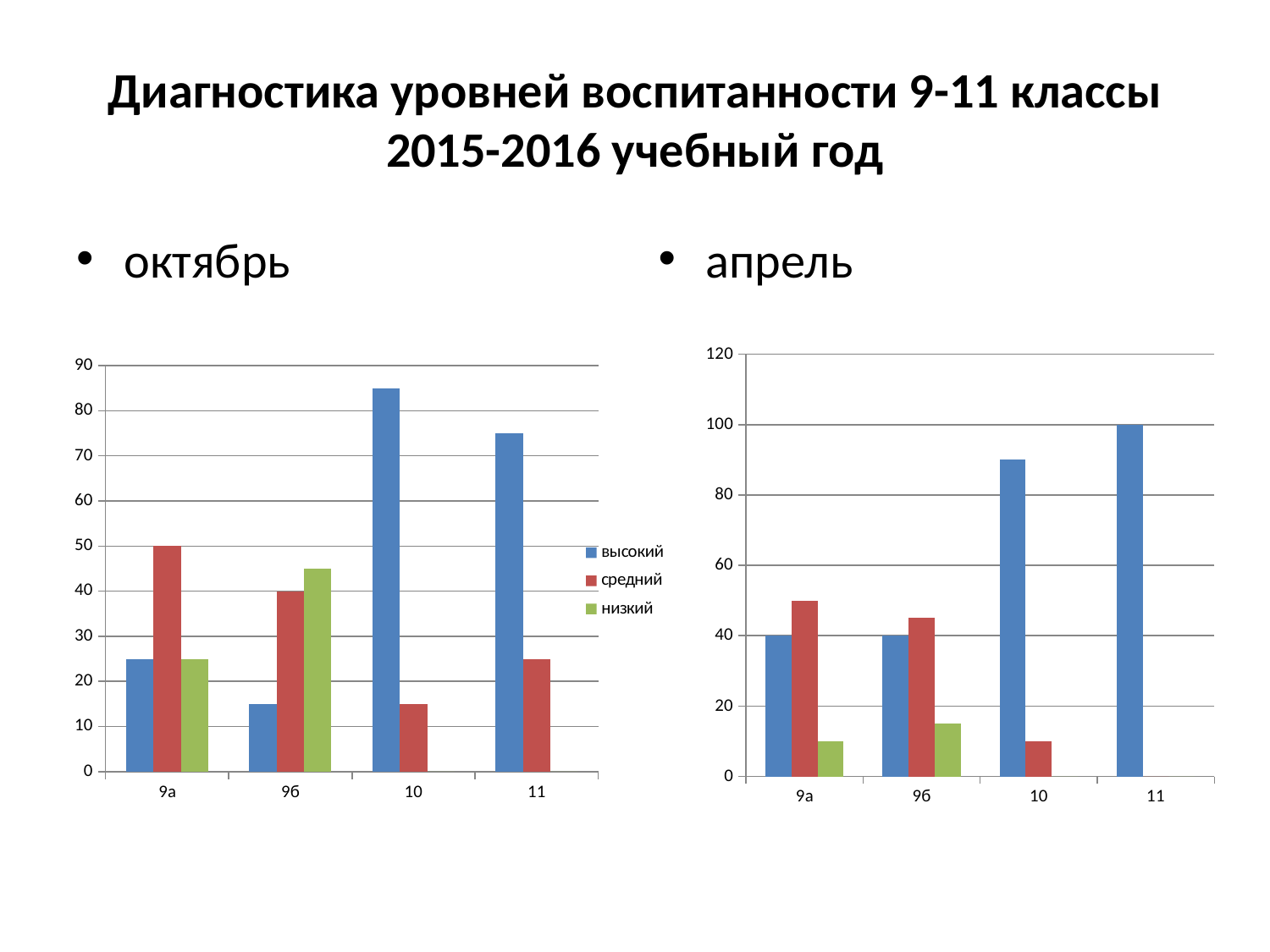
What kind of chart is the left chart (октябрь)? bar chart In the right chart (апрель), is the blue (высокий) value for 10 greater or less than 80? greater In the left chart (октябрь), what is the value of средний for 9а? 50 In the left chart (октябрь), which is larger for 9а: высокий or средний? средний How many categories are shown on the x axis of the left chart (октябрь)? 4 In the left chart (октябрь), which category has the highest высокий value? 10 What label is written above the right chart? апрель In the right chart (апрель), what is the value of the blue (высокий) bar for 9а? 40 In the left chart (октябрь), is the высокий value for 10 greater or less than 80? greater How many series does the legend of the left chart (октябрь) list? 3 In the left chart (октябрь), what is the value of средний for 9б? 40 In the right chart (апрель), what is the value of the blue (высокий) bar for 11? 100